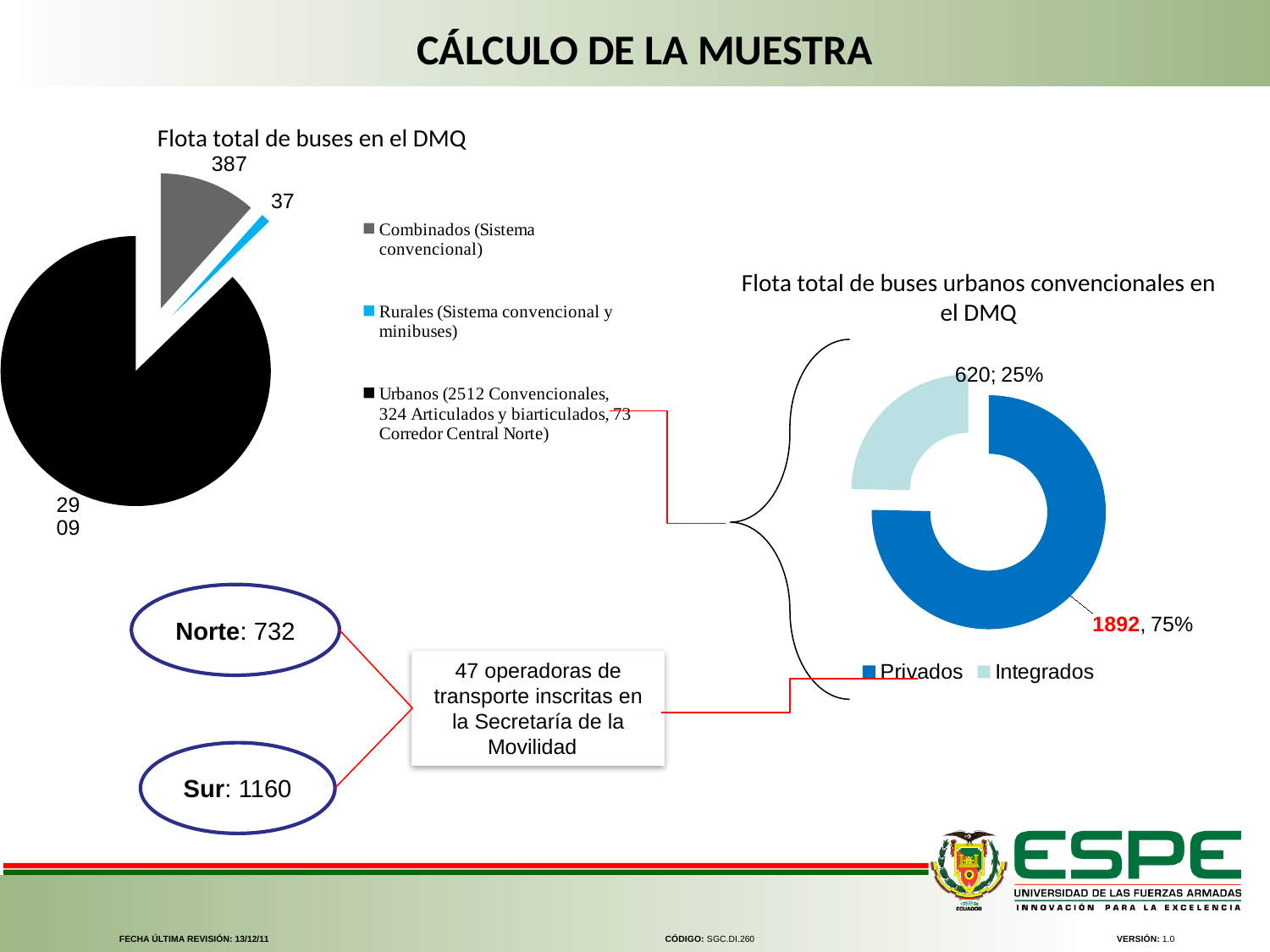
In the chart 'Flota total de buses urbanos convencionales en el DMQ', what is the value for Privados? 1892 What kind of chart is 'Flota total de buses en el DMQ'? Pie chart How many entries does the legend of the chart 'Flota total de buses urbanos convencionales en el DMQ' list? 2 In the chart 'Flota total de buses en el DMQ', what is the value for Rurales (Sistema convencional y minibuses)? 37 In the chart 'Flota total de buses en el DMQ', which category has the smallest slice? Rurales How many categories does the chart 'Flota total de buses en el DMQ' show? 3 In the chart 'Flota total de buses en el DMQ', what is the difference between the Combinados and Rurales values? 350 In the chart 'Flota total de buses urbanos convencionales en el DMQ', what is the difference between Privados and Integrados? 1272 In the chart 'Flota total de buses en el DMQ', which category has the largest slice? Urbanos In the chart 'Flota total de buses urbanos convencionales en el DMQ', what share of the total is Integrados? 25% In the chart 'Flota total de buses en el DMQ', what is the value for Combinados (Sistema convencional)? 387 In the chart 'Flota total de buses urbanos convencionales en el DMQ', which is larger, Privados or Integrados? Privados